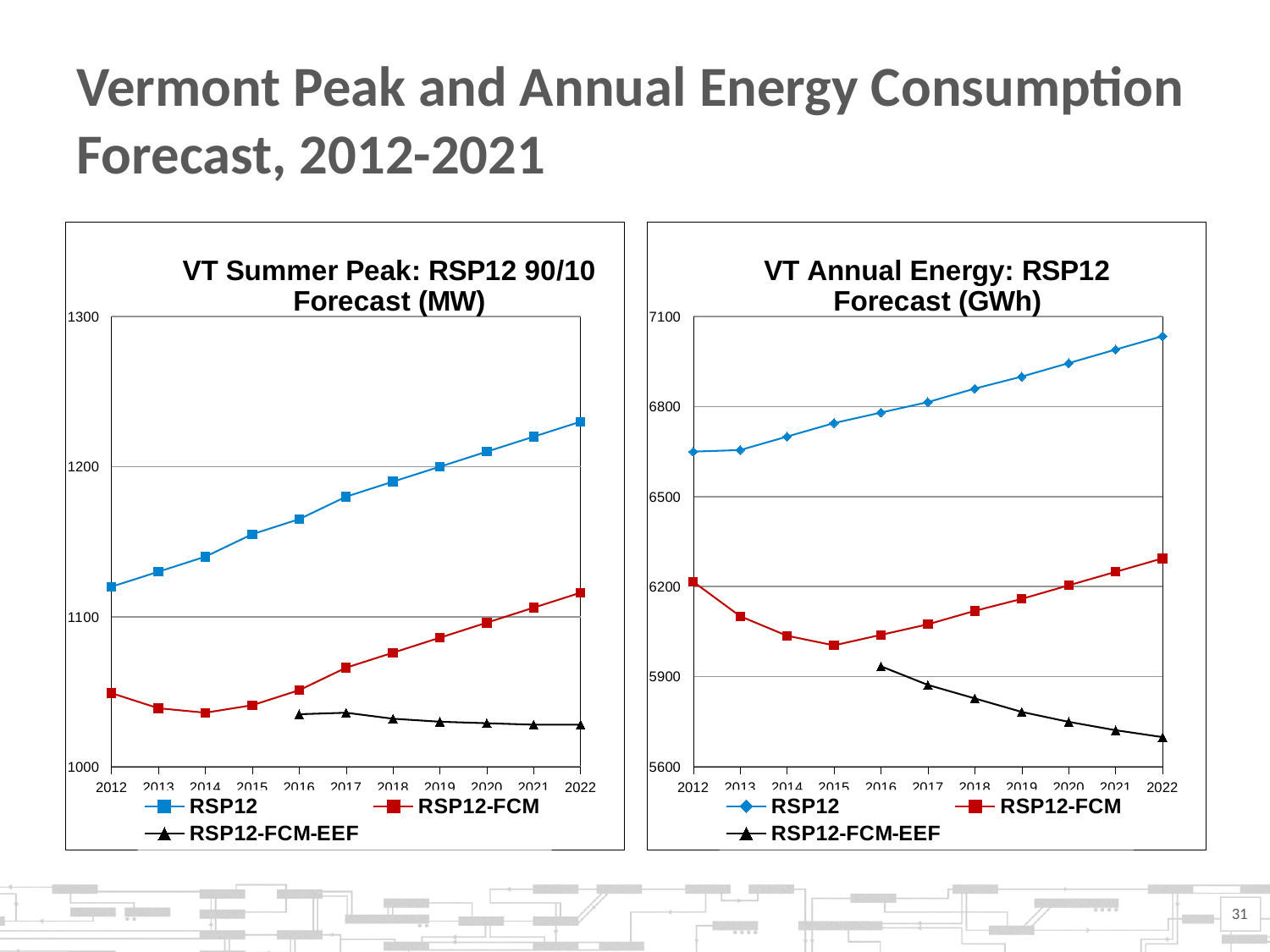
In the VT Annual Energy chart, in which year is the RSP12-FCM series at its lowest? 2015 In the VT Summer Peak chart, is the RSP12 value for 2022 greater or less than 1200? greater In the VT Annual Energy chart, is the RSP12 value for 2022 greater or less than 6800? greater In the VT Annual Energy chart, how many data points does the RSP12-FCM-EEF series have? 7 In the VT Summer Peak chart, does the RSP12 series rise or fall from 2012 to 2022? rise How many series does the legend of the VT Annual Energy chart list? 3 In the VT Annual Energy chart, does the RSP12-FCM-EEF series rise or fall from 2016 to 2022? fall In the VT Summer Peak chart, which series is higher in 2020, RSP12 or RSP12-FCM? RSP12 In the VT Summer Peak chart, is the RSP12-FCM value for 2012 greater or less than 1100? less In the VT Summer Peak chart, how many years are shown on the x axis? 11 What kind of chart is the VT Summer Peak chart on the left? line chart